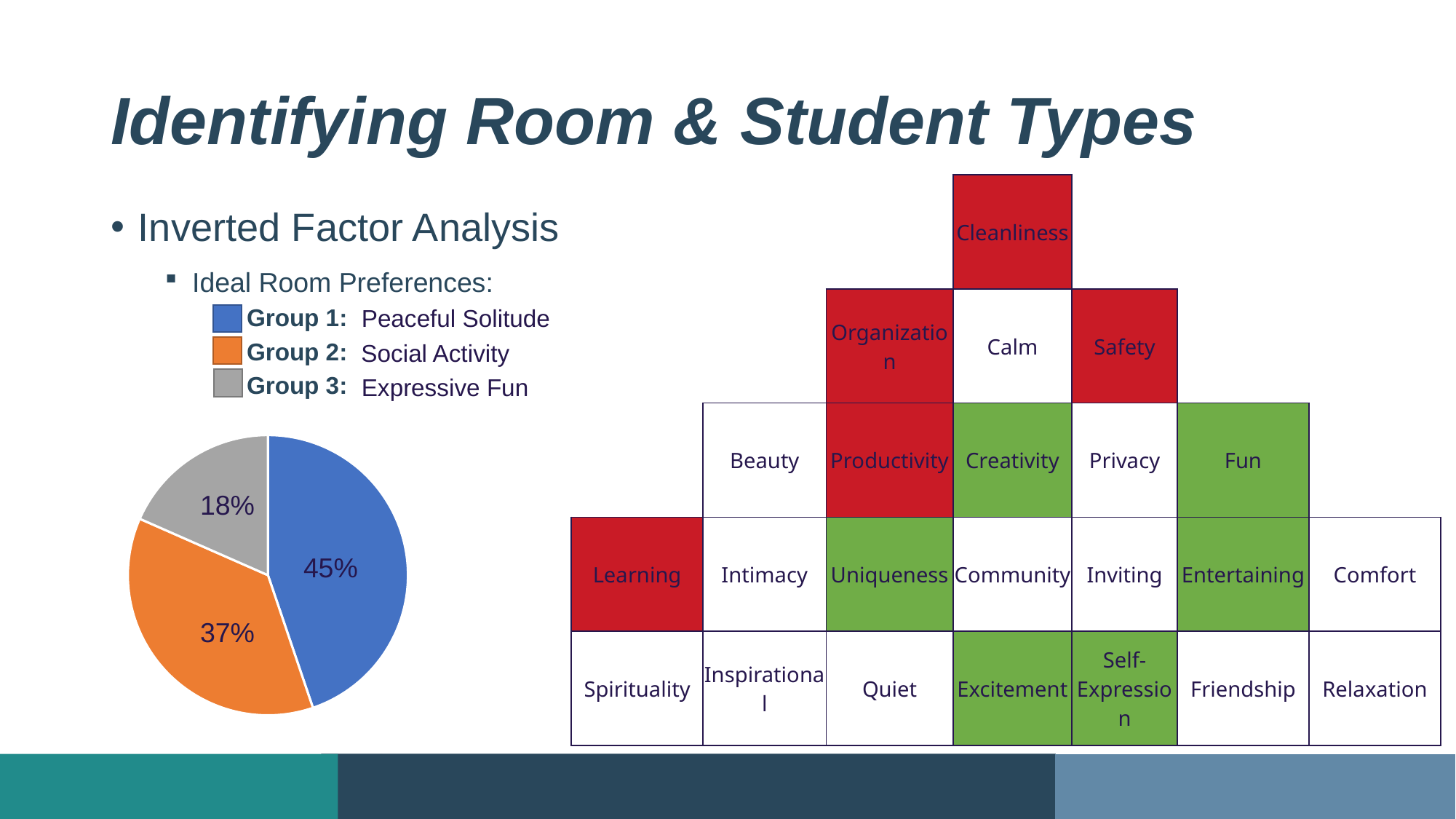
What kind of chart is shown on the left of the slide? pie chart What colour is the slice labelled 18% in the pie chart? gray What is the difference between the Group 1 and Group 3 shares in the pie chart? 27 percentage points What share of the pie chart does Group 2 (Social Activity) represent? 37% What share of the pie chart does Group 3 (Expressive Fun) represent? 18% Which group has the smallest slice in the pie chart? Group 3 (Expressive Fun) What colour is the Group 2 (Social Activity) slice in the pie chart? orange Which group has the largest slice in the pie chart? Group 1 (Peaceful Solitude) What share of the pie chart does Group 1 (Peaceful Solitude) represent? 45% In the pie chart, which is larger: the Group 2 slice or the Group 3 slice? Group 2 By how many percentage points does the Group 1 slice exceed the Group 2 slice in the pie chart? 8 percentage points How many slices does the pie chart have? 3